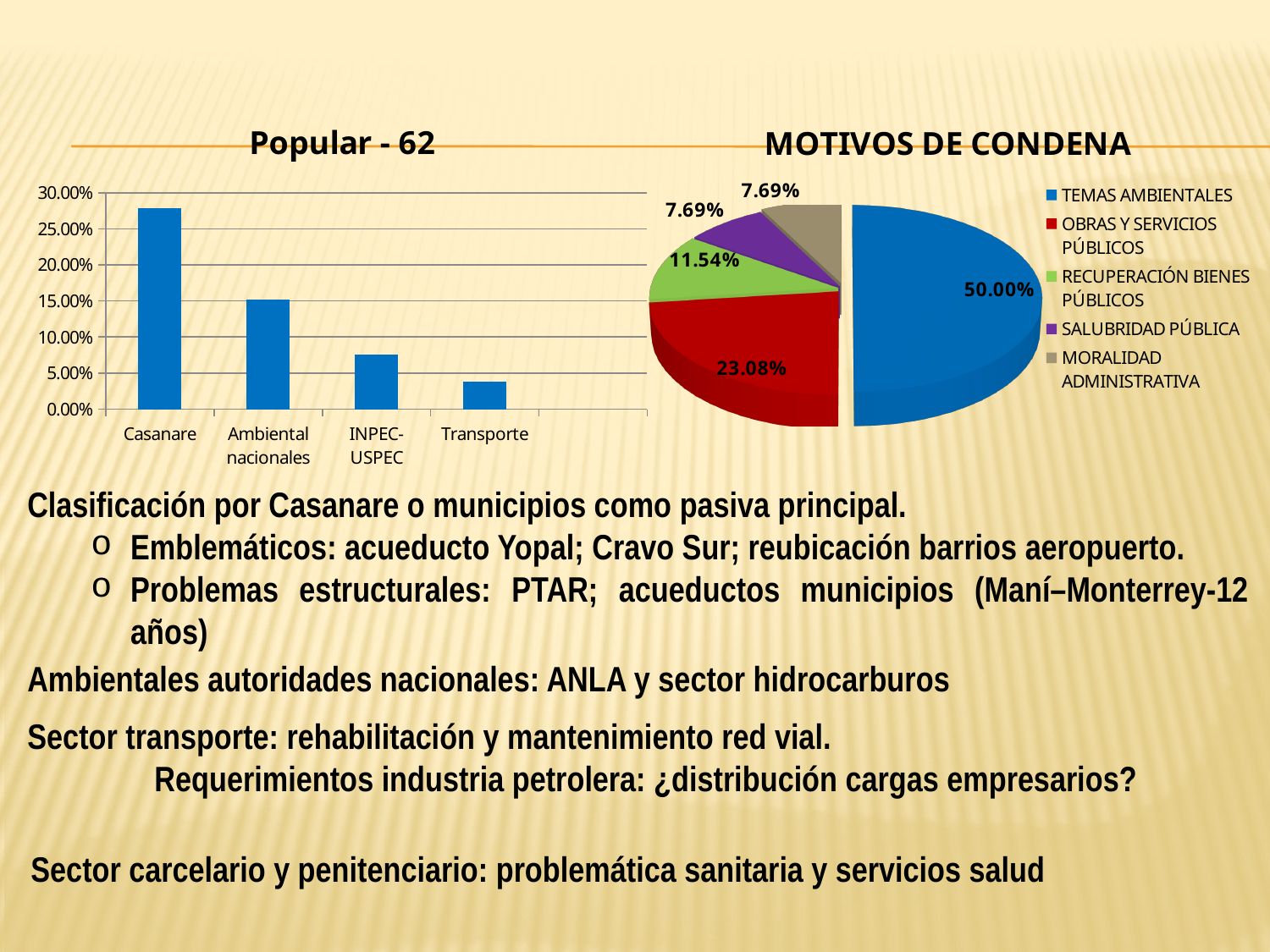
In the 'Popular - 62' chart, is the value for Casanare greater or less than 25.00%? greater In the 'Popular - 62' chart, how many categories are shown on the x axis? 4 In the 'Popular - 62' chart, which category has the lowest bar? Transporte In the 'MOTIVOS DE CONDENA' chart, what is the value for OBRAS Y SERVICIOS PÚBLICOS? 23.08% In the 'MOTIVOS DE CONDENA' chart, what share does TEMAS AMBIENTALES have? 50.00% In the 'Popular - 62' chart, is the value for Transporte greater or less than 5.00%? less In the 'Popular - 62' chart, is the value for Ambiental nacionales greater or less than 10.00%? greater In the 'MOTIVOS DE CONDENA' chart, what is the value for RECUPERACIÓN BIENES PÚBLICOS? 11.54% What kind of chart is 'Popular - 62'? Bar chart In the 'Popular - 62' chart, do the bar values rise or fall from left to right? Fall In the 'Popular - 62' chart, which category has the highest bar? Casanare In the 'MOTIVOS DE CONDENA' chart, how many entries does the legend list? 5